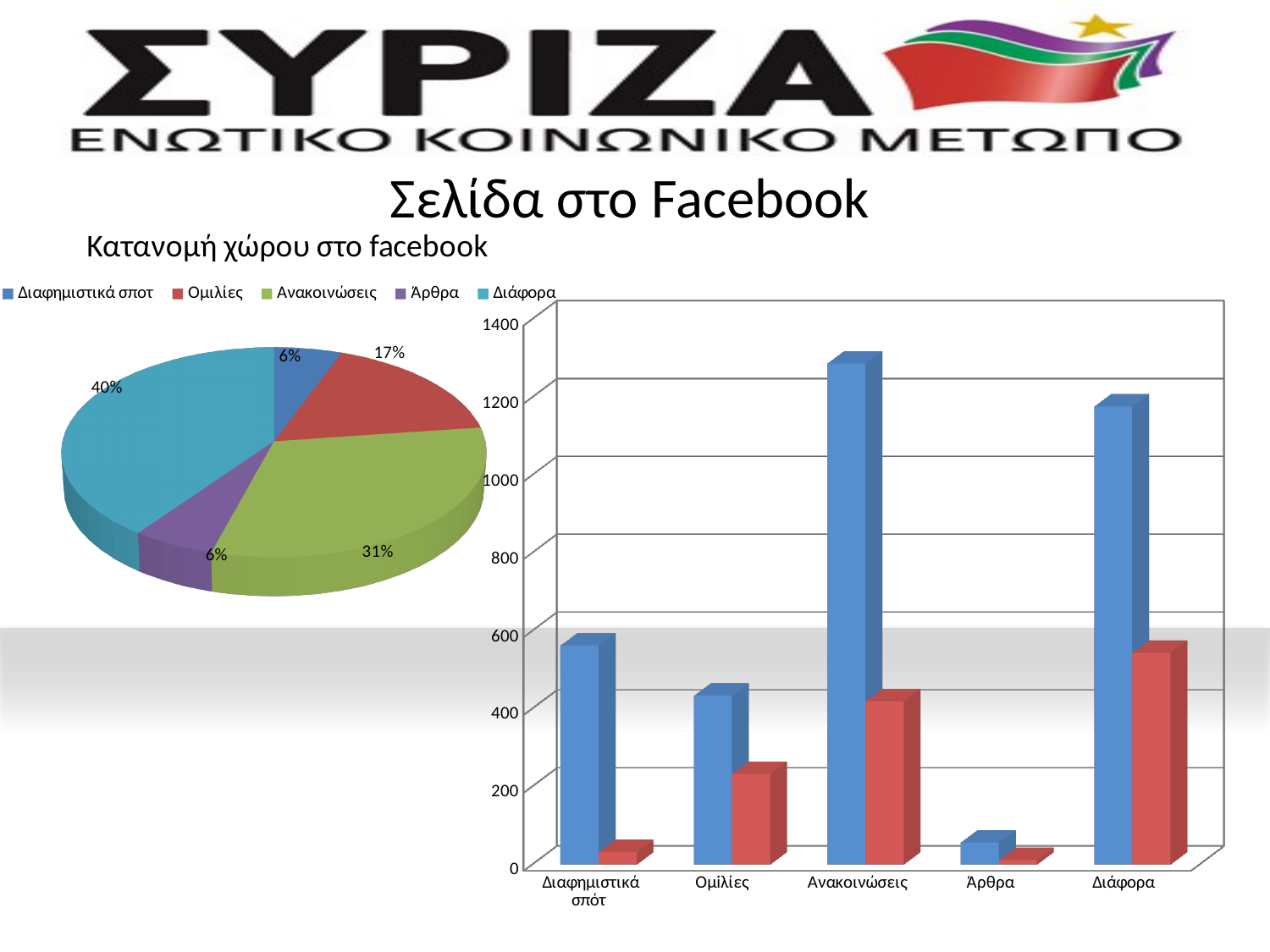
In the bar chart on the right, which category has the tallest blue bar? Ανακοινώσεις In the pie chart on the left, what is the difference in percentage points between the Διάφορα and Ανακοινώσεις shares? 9 In the pie chart on the left, what share does Ανακοινώσεις have? 31% In the pie chart on the left, what share does Διάφορα have? 40% In the bar chart on the right, is the red bar for Ομιλίες greater or less than 400? less In the bar chart on the right, is the blue bar for Ανακοινώσεις greater or less than 1200? greater In the pie chart on the left, how many categories does the legend list? 5 In the bar chart on the right, which category has the shortest blue bar? Άρθρα What kind of chart is the chart on the right of the slide? bar chart In the pie chart on the left, which category has the largest share? Διάφορα In the pie chart on the left, what share does Ομιλίες have? 17% In the bar chart on the right, how many categories are shown on the x axis? 5